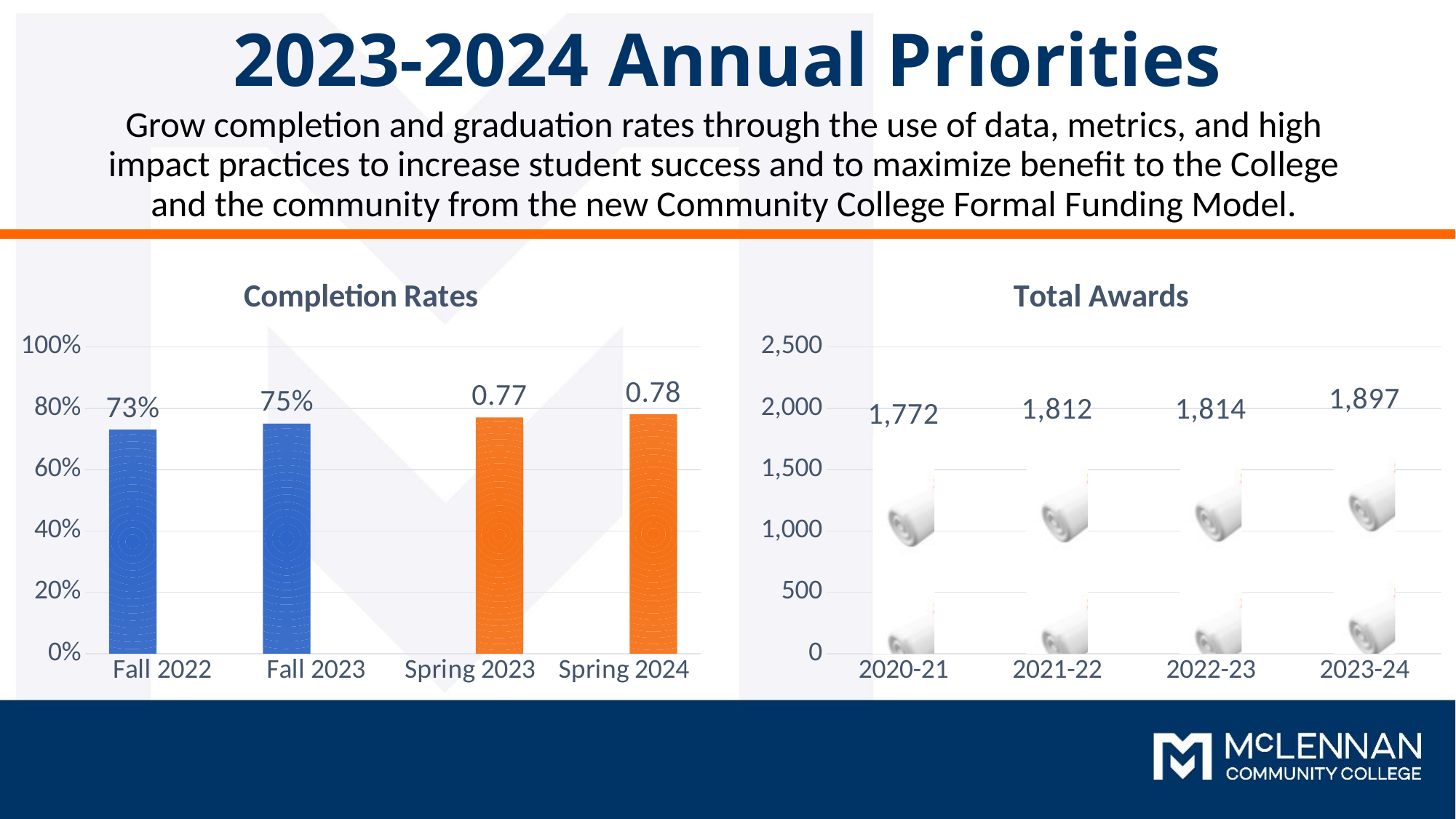
In the Total Awards chart, which year has the highest value? 2023-24 In the Completion Rates chart, what is the value for Fall 2022? 73% In the Completion Rates chart, what is the value labelled for Spring 2023? 0.77 In the Total Awards chart, what is the value for 2023-24? 1,897 In the Total Awards chart, which year has the lowest value? 2020-21 In the Completion Rates chart, what is the value labelled for Spring 2024? 0.78 In the Total Awards chart, what is the value for 2021-22? 1,812 What kind of chart is the Completion Rates chart? bar chart In the Completion Rates chart, which is larger, Fall 2022 or Fall 2023? Fall 2023 In the Total Awards chart, do the values rise or fall from 2020-21 to 2023-24? rise How many categories are shown on the x axis of the Completion Rates chart? 4 In the Total Awards chart, what is the difference between the 2023-24 and 2020-21 values? 125